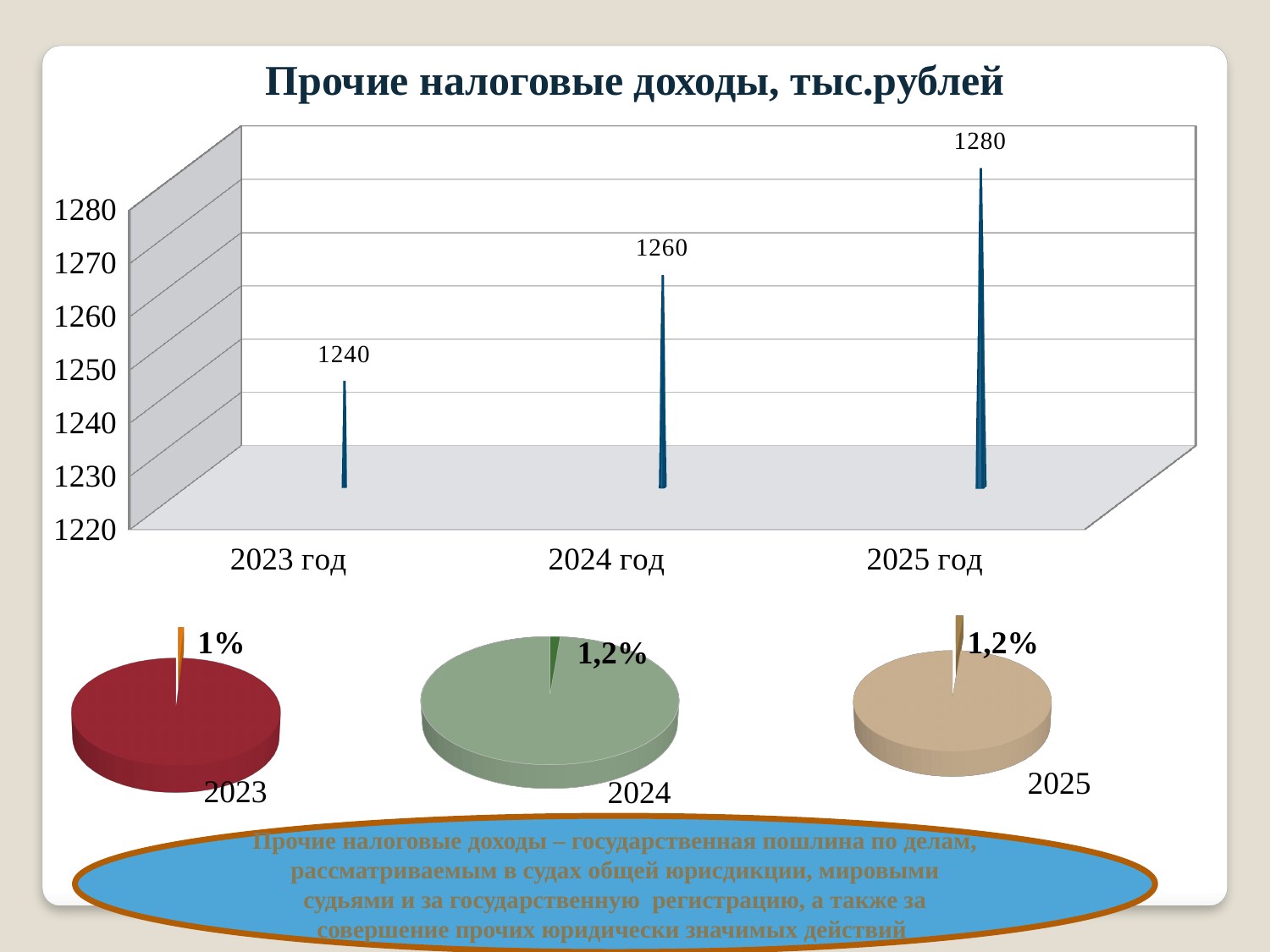
In the chart titled 'Прочие налоговые доходы, тыс.рублей', do the values rise or fall from 2023 год to 2025 год? rise In the chart titled 'Прочие налоговые доходы, тыс.рублей', how many categories are shown on the x axis? 3 In the pie chart labelled 2023 at the bottom left of the slide, what share is shown for the small slice? 1% In the chart titled 'Прочие налоговые доходы, тыс.рублей', what is the value for 2024 год? 1260 In the pie chart labelled 2025 at the bottom right of the slide, what share is shown for the small slice? 1,2% In the chart titled 'Прочие налоговые доходы, тыс.рублей', which year has the lowest value? 2023 год In the chart titled 'Прочие налоговые доходы, тыс.рублей', is the value for 2024 год greater or less than 1250? greater What kind of chart is the one titled 'Прочие налоговые доходы, тыс.рублей'? bar chart In the chart titled 'Прочие налоговые доходы, тыс.рублей', what is the value for 2023 год? 1240 In the chart titled 'Прочие налоговые доходы, тыс.рублей', what is the value for 2025 год? 1280 In the chart titled 'Прочие налоговые доходы, тыс.рублей', what is the difference between the values for 2025 год and 2023 год? 40 In the chart titled 'Прочие налоговые доходы, тыс.рублей', which year has the highest value? 2025 год